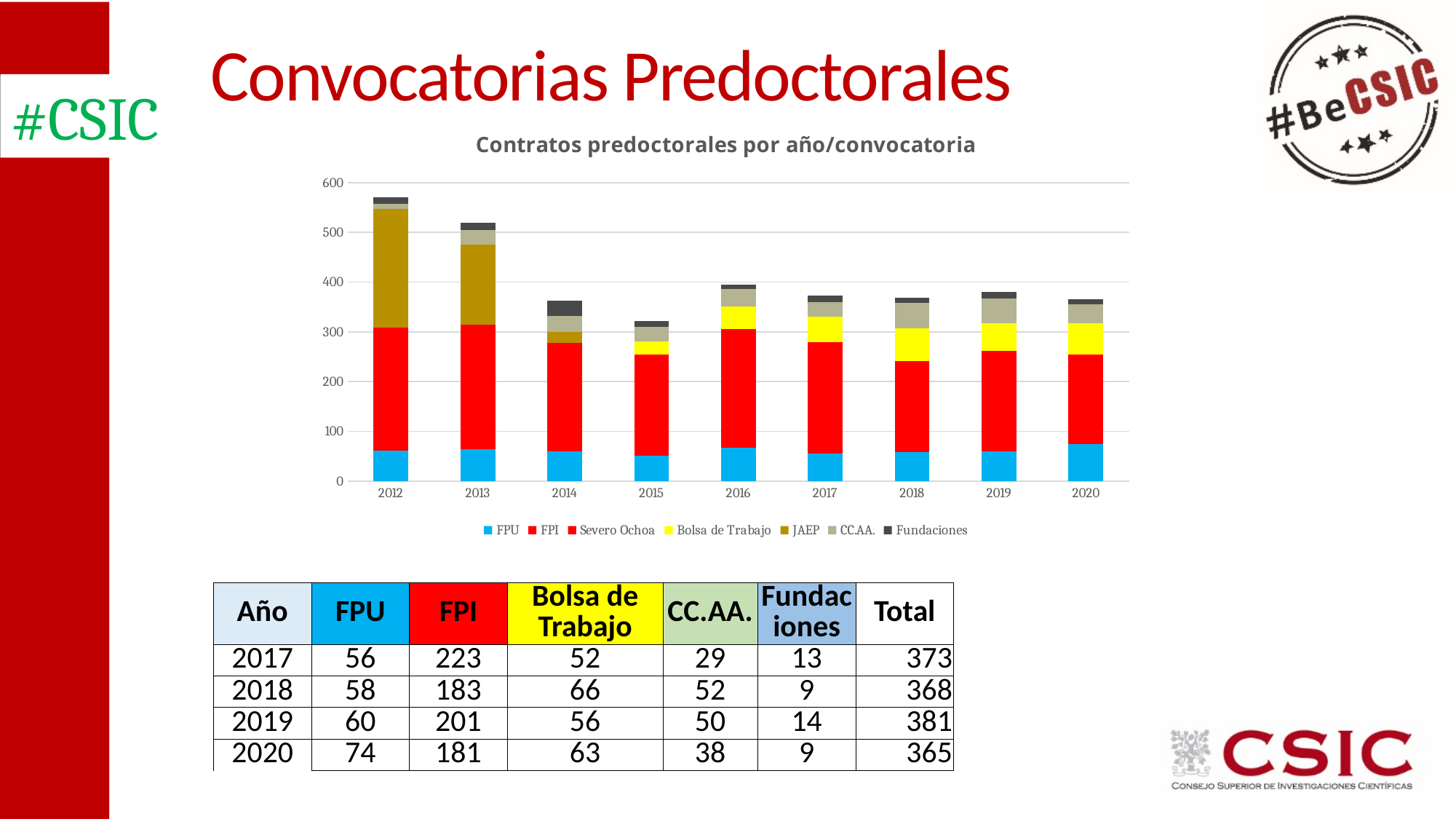
Which year has the shortest stacked bar in the chart? 2015 Which year has the tallest stacked bar in the chart? 2012 According to the table on the slide, what is the total number of contracts for 2019? 381 Is the total bar height for 2015 greater or less than 400? less According to the table on the slide, what is the difference between the FPI contracts in 2017 and in 2018? 40 What kind of chart is shown on the slide? bar chart How many series does the chart legend list? 7 Is the total bar height for 2012 greater or less than 500? greater According to the table on the slide, how many FPU contracts were there in 2020? 74 How many years are shown on the x axis of the chart? 9 Which year has the taller stacked bar, 2012 or 2013? 2012 Do the total bar heights rise or fall from 2012 to 2015? fall